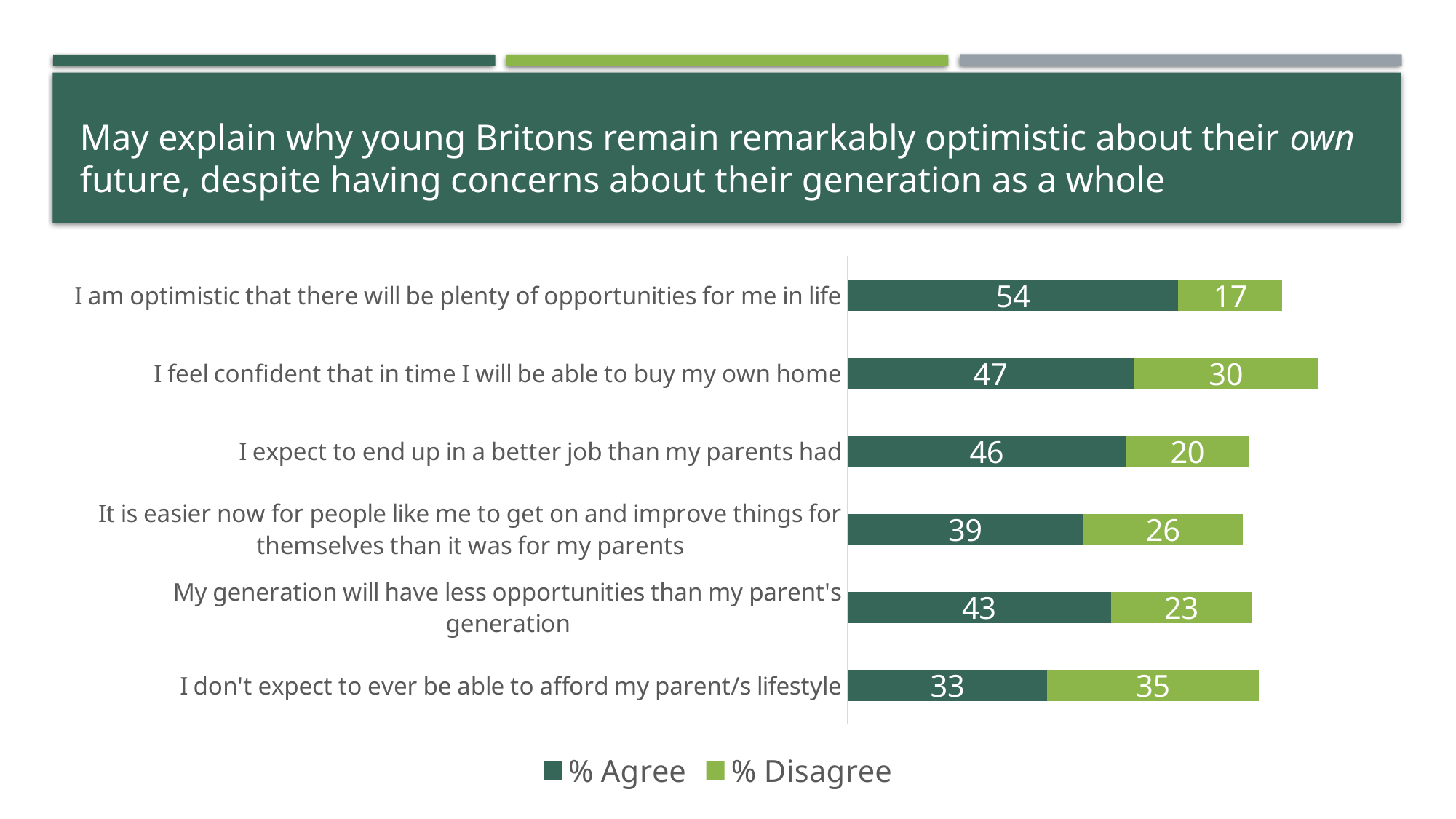
Which statement has the highest % Agree value? I am optimistic that there will be plenty of opportunities for me in life Which statement has the lowest % Disagree value? I am optimistic that there will be plenty of opportunities for me in life What is the % Agree value for "I don't expect to ever be able to afford my parent/s lifestyle"? 33 For "I don't expect to ever be able to afford my parent/s lifestyle", which is larger: % Agree or % Disagree? % Disagree What is the difference between the % Agree and % Disagree values for "I expect to end up in a better job than my parents had"? 26 What kind of chart is shown on the slide? Stacked bar chart What is the % Agree value for "I am optimistic that there will be plenty of opportunities for me in life"? 54 What is the total of the stacked bar for "My generation will have less opportunities than my parent's generation"? 66 How many statements are shown in the chart? 6 What is the % Disagree value for "I feel confident that in time I will be able to buy my own home"? 30 How many series does the legend list? 2 Which series is shown in light green in the legend? % Disagree